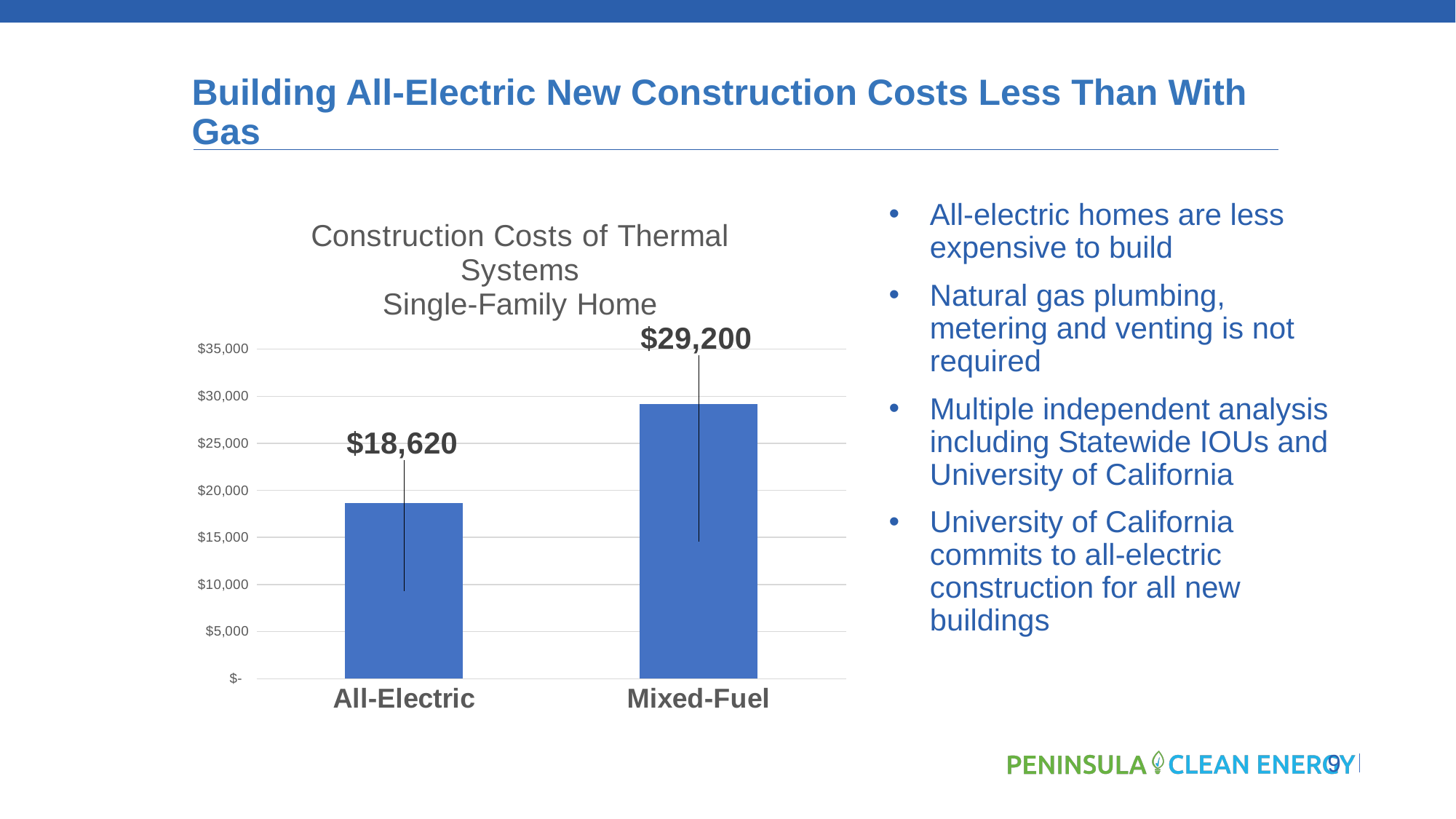
Which category has the higher construction cost? Mixed-Fuel Is the construction cost for Mixed-Fuel greater or less than $25,000? greater Which category has the lower construction cost? All-Electric Is the construction cost for All-Electric greater or less than $20,000? less What is the highest value labelled on the chart's vertical axis? $35,000 What kind of chart is shown on the slide? bar chart What is the construction cost shown for All-Electric? $18,620 Is the All-Electric cost larger or smaller than the Mixed-Fuel cost? smaller What is the title of the chart? Construction Costs of Thermal Systems Single-Family Home What is the difference in construction cost between Mixed-Fuel and All-Electric? $10,580 How many categories are shown on the chart? 2 What is the construction cost shown for Mixed-Fuel? $29,200